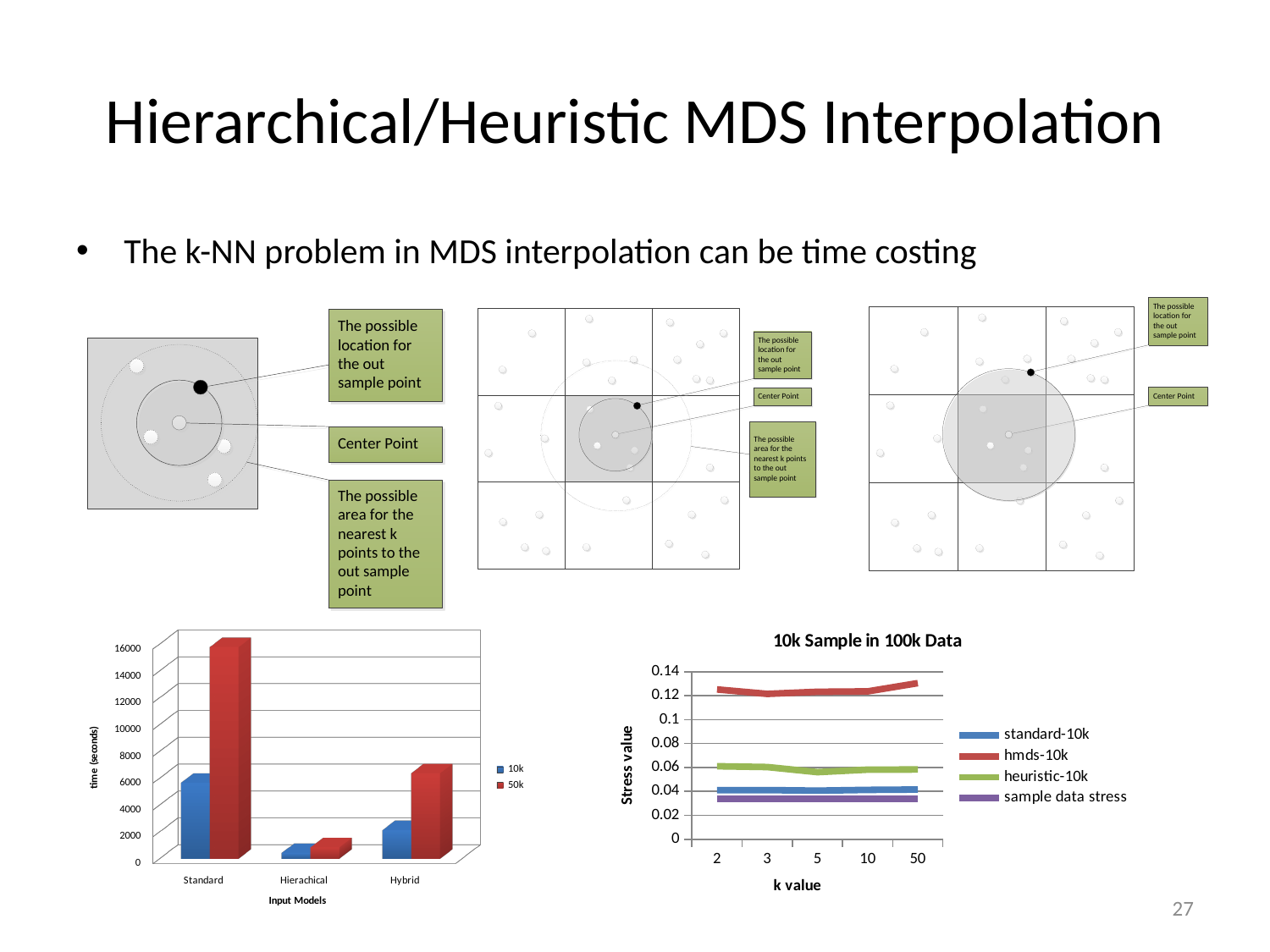
What kind of chart is the bottom-left chart with the 'Input Models' axis? bar chart In the bottom-left bar chart, how many input models are shown on the x axis? 3 In the '10k Sample in 100k Data' chart, is the hmds-10k value at k = 50 greater or less than 0.12? greater In the bottom-left bar chart, is the 50k value for Hierarchical greater or less than 2000? less In the bottom-left bar chart, is the 50k value for Standard greater or less than 14000? greater In the bottom-left bar chart, which input model has the highest 50k time? Standard In the bottom-left bar chart, which input model has the lowest 10k time? Hierachical In the bottom-left bar chart, which is larger for Hybrid, the 10k value or the 50k value? 50k In the '10k Sample in 100k Data' chart, how many series does the legend list? 4 In the '10k Sample in 100k Data' chart, which series has the highest stress value? hmds-10k In the '10k Sample in 100k Data' chart, how many k values are shown on the x axis? 5 In the bottom-left bar chart, how many series does the legend list? 2